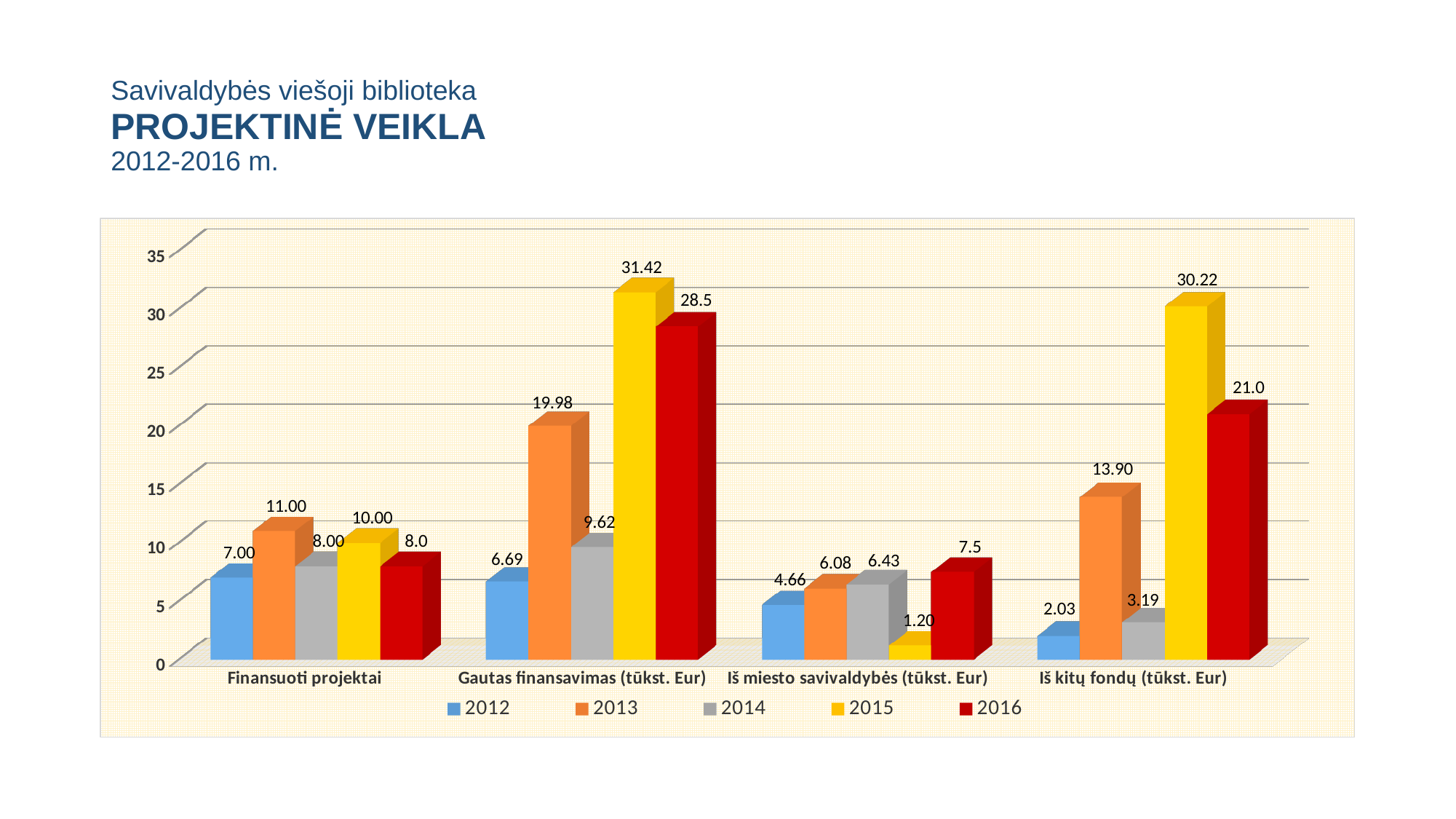
Which year has the lowest value in the Iš kitų fondų (tūkst. Eur) category? 2012 What is the value for 2013 in the Iš kitų fondų (tūkst. Eur) category? 13.90 How many series does the legend list? 5 How many categories are shown on the x axis? 4 What is the value for 2012 in the Finansuoti projektai category? 7.00 Which is larger in the Iš miesto savivaldybės (tūkst. Eur) category: the 2014 value or the 2016 value? 2016 What kind of chart is shown on the slide? Bar chart What is the difference between the 2015 and 2016 values in the Gautas finansavimas (tūkst. Eur) category? 2.92 What is the value for 2015 in the Gautas finansavimas (tūkst. Eur) category? 31.42 What is the value for 2015 in the Iš miesto savivaldybės (tūkst. Eur) category? 1.20 Which colour represents the 2015 series in the chart? Yellow Which year has the highest value in the Finansuoti projektai category? 2013